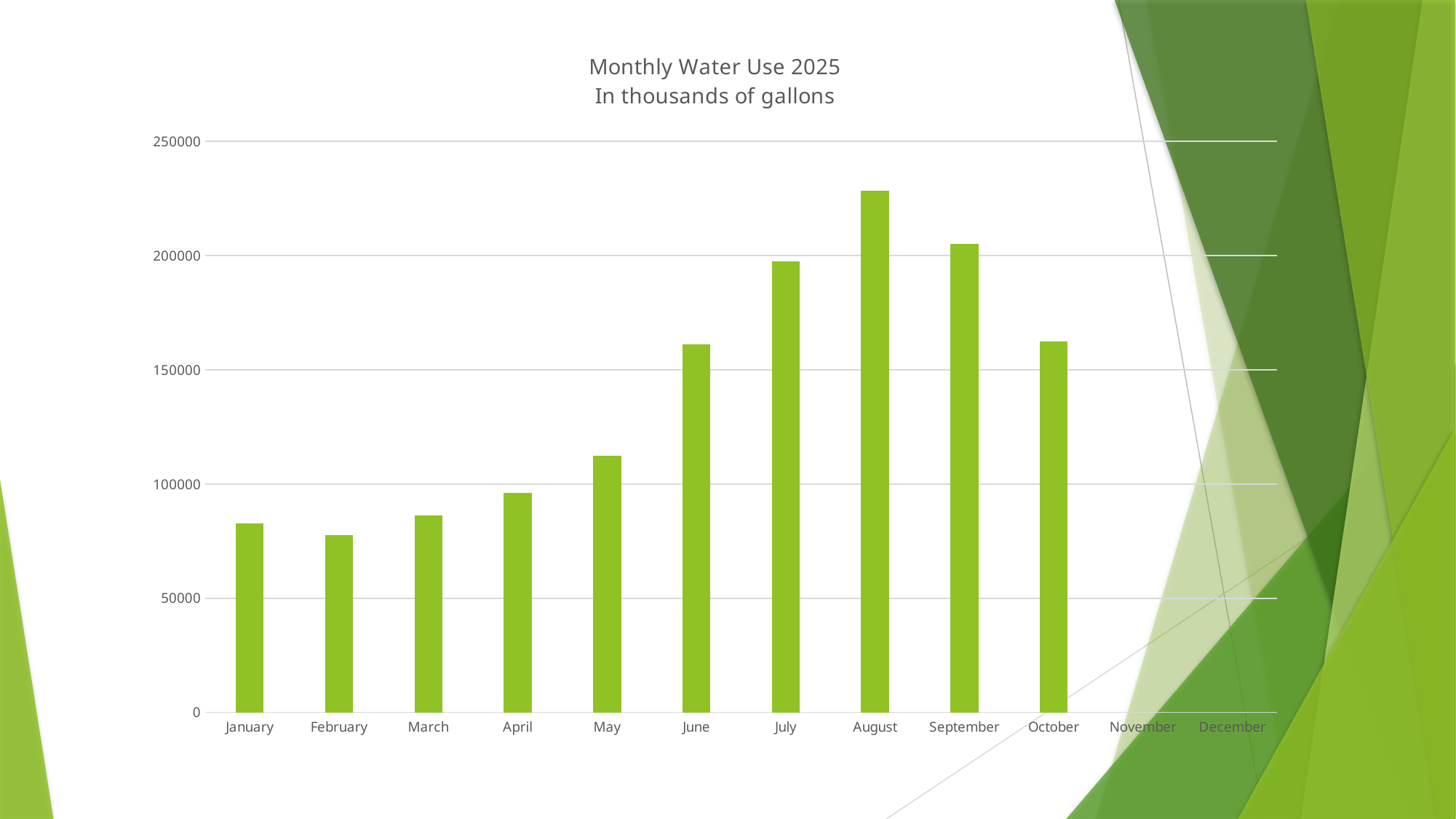
Is the value for August greater or less than 200000? greater How many months are labelled on the x axis? 12 Is the value for June greater or less than 150000? greater Which is larger, the value for July or the value for May? July Is the value for January greater or less than 100000? less Which is larger, the value for April or the value for September? September Which month has the highest water use? August Do the values rise or fall from January to August? rise Which month with a bar has the lowest water use? February What kind of chart is shown on the slide? bar chart